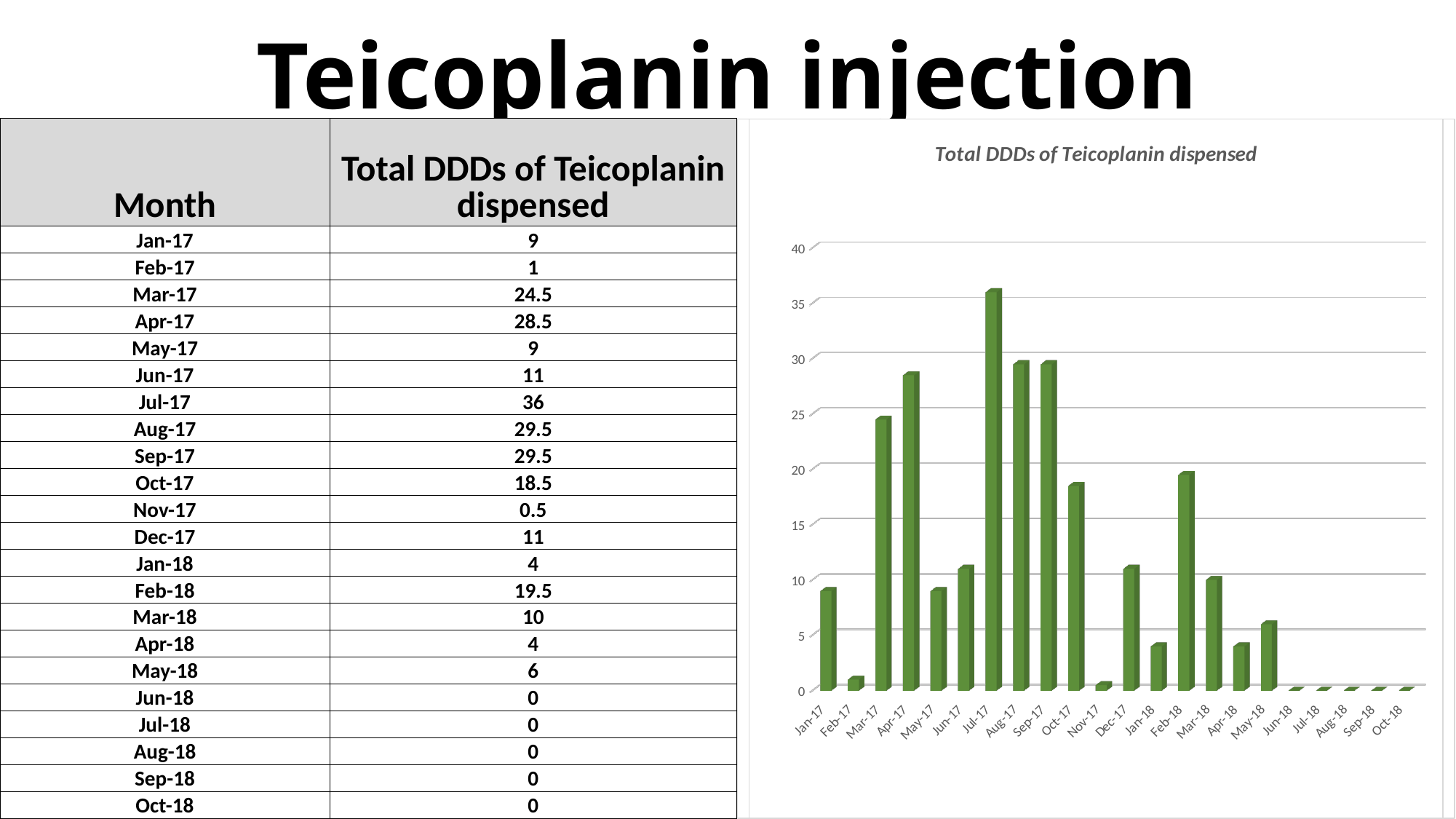
How many months are plotted on the x axis of the chart? 22 What is the total DDDs of Teicoplanin dispensed in Jul-17? 36 What is the difference between the total DDDs dispensed in Apr-17 and Mar-17? 4 Is the value for Jul-17 greater or less than 35? greater What is the title of the chart? Total DDDs of Teicoplanin dispensed What is the total DDDs of Teicoplanin dispensed in Apr-17? 28.5 Which is larger, the total DDDs dispensed in Mar-17 or in Dec-17? Mar-17 What is the difference between the total DDDs dispensed in Jul-17 and Aug-17? 6.5 What is the total DDDs of Teicoplanin dispensed in Feb-18? 19.5 What kind of chart is shown on the slide? bar chart Which month has the highest total DDDs of Teicoplanin dispensed? Jul-17 Do the values rise or fall from Jul-17 to Nov-17? fall